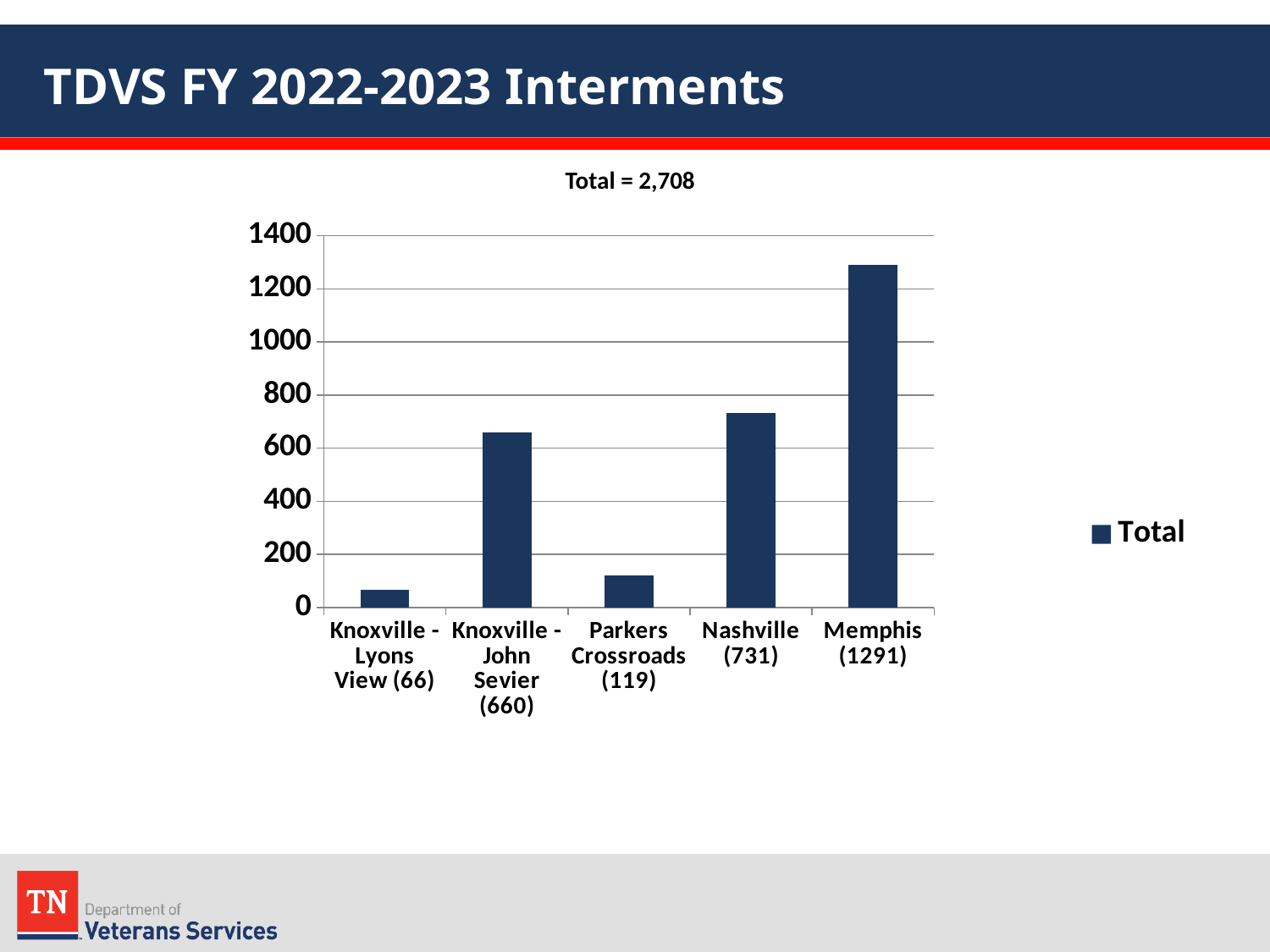
What is the number of interments for Parkers Crossroads? 119 Which location has the highest number of interments? Memphis How many locations are shown in the chart? 5 Which location has the lowest number of interments? Knoxville - Lyons View Is the value for Nashville greater or less than 800? less What is the number of interments for Memphis? 1291 What kind of chart is shown on the slide? bar chart What total is stated in the chart title? 2,708 Which has more interments, Knoxville - John Sevier or Parkers Crossroads? Knoxville - John Sevier What is the difference in interments between Nashville and Knoxville - John Sevier? 71 What is the difference in interments between Memphis and Nashville? 560 What is the number of interments for Knoxville - Lyons View? 66